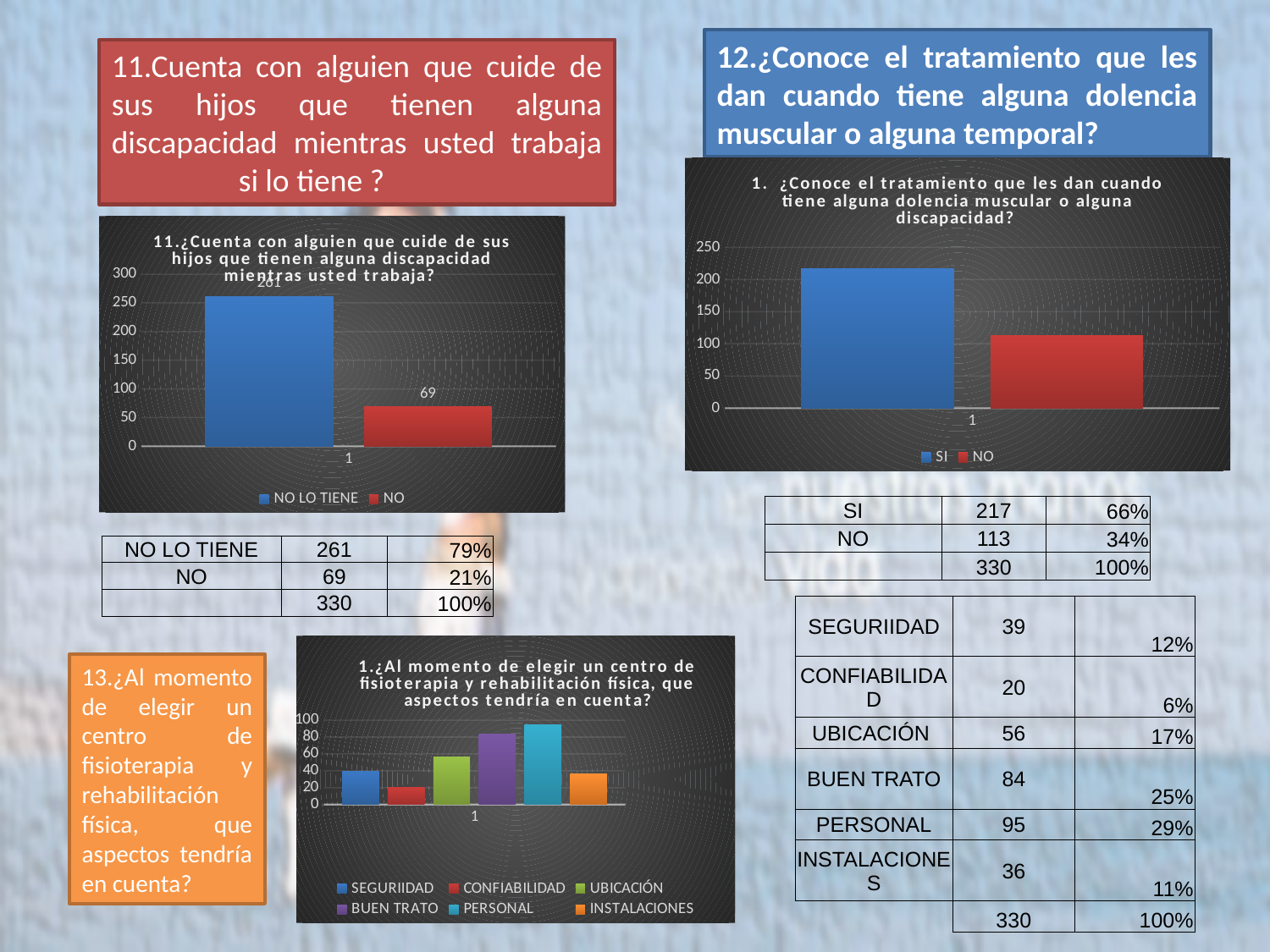
In the top-right chart (question 12), is the value for NO greater or less than 150? less In the top-left chart (question 11), how many series does the legend list? 2 In the bottom chart (question 13), how many series does the legend list? 6 In the bottom chart (question 13), which series has the highest bar? PERSONAL In the top-right chart (question 12), what colour is the SI bar? blue In the top-left chart (question 11), what is the value for NO LO TIENE? 261 In the bottom chart (question 13), which series has the lowest bar? CONFIABILIDAD In the top-right chart (question 12), which series has the higher bar, SI or NO? SI In the top-left chart (question 11), what is the value for NO? 69 In the top-right chart (question 12), is the value for SI greater or less than 200? greater In the top-left chart (question 11), what is the difference between the NO LO TIENE value and the NO value? 192 What kind of chart is the top-left chart (question 11)? bar chart